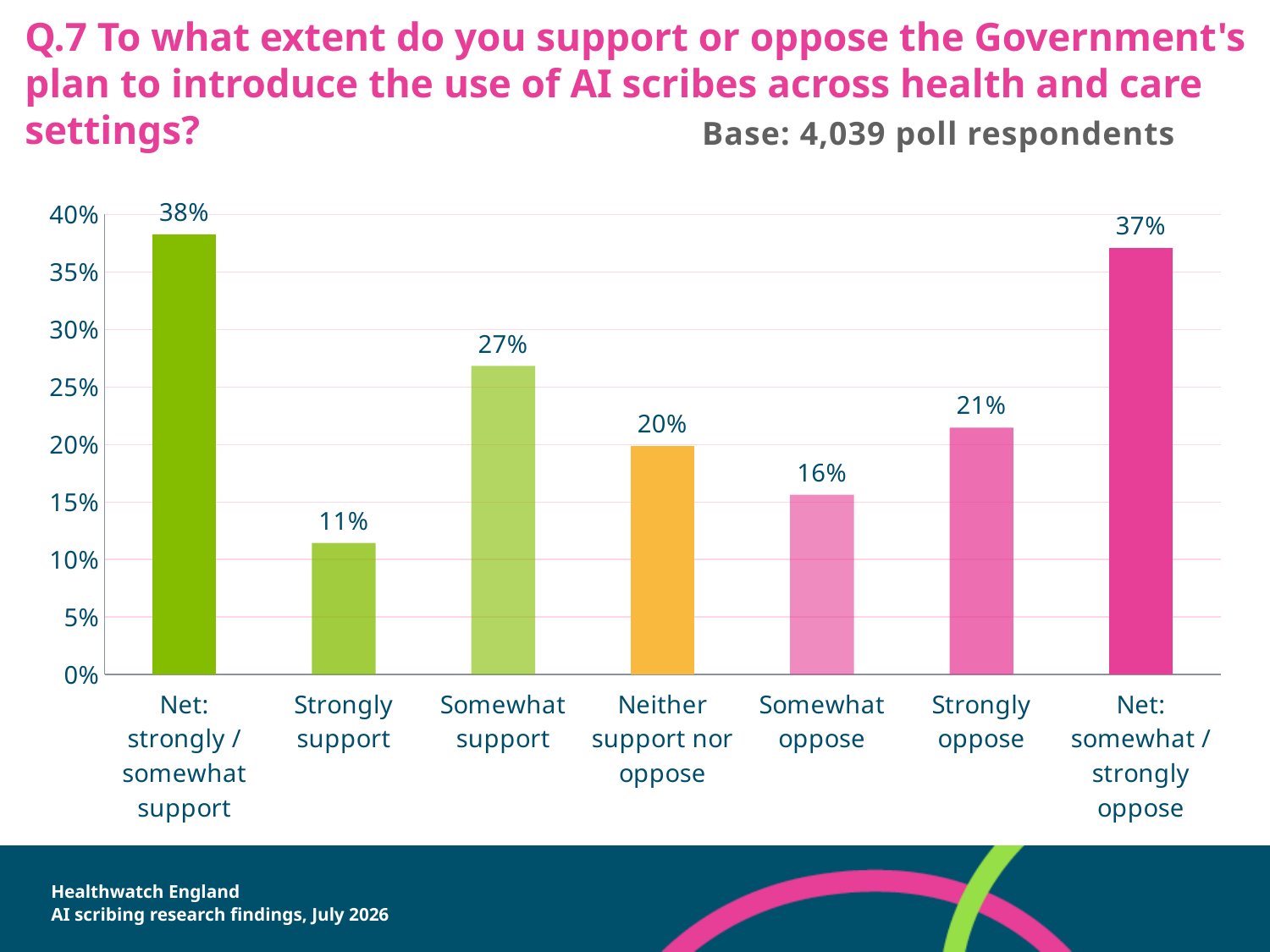
What is the value for 'Net: somewhat / strongly oppose'? 37% What is the value for 'Neither support nor oppose'? 20% What percentage of respondents said they strongly support the plan? 11% Is the value for 'Somewhat support' greater or less than 25%? greater Which category has the highest value? Net: strongly / somewhat support What is the difference between 'Somewhat support' and 'Strongly support'? 16 percentage points What kind of chart is shown on the slide? Bar chart How many categories are shown on the x axis? 7 Which category has the lowest value? Strongly support What is the base number of poll respondents stated on the slide? 4,039 What percentage of respondents somewhat oppose the plan? 16% Which is larger: 'Strongly oppose' or 'Somewhat oppose'? Strongly oppose